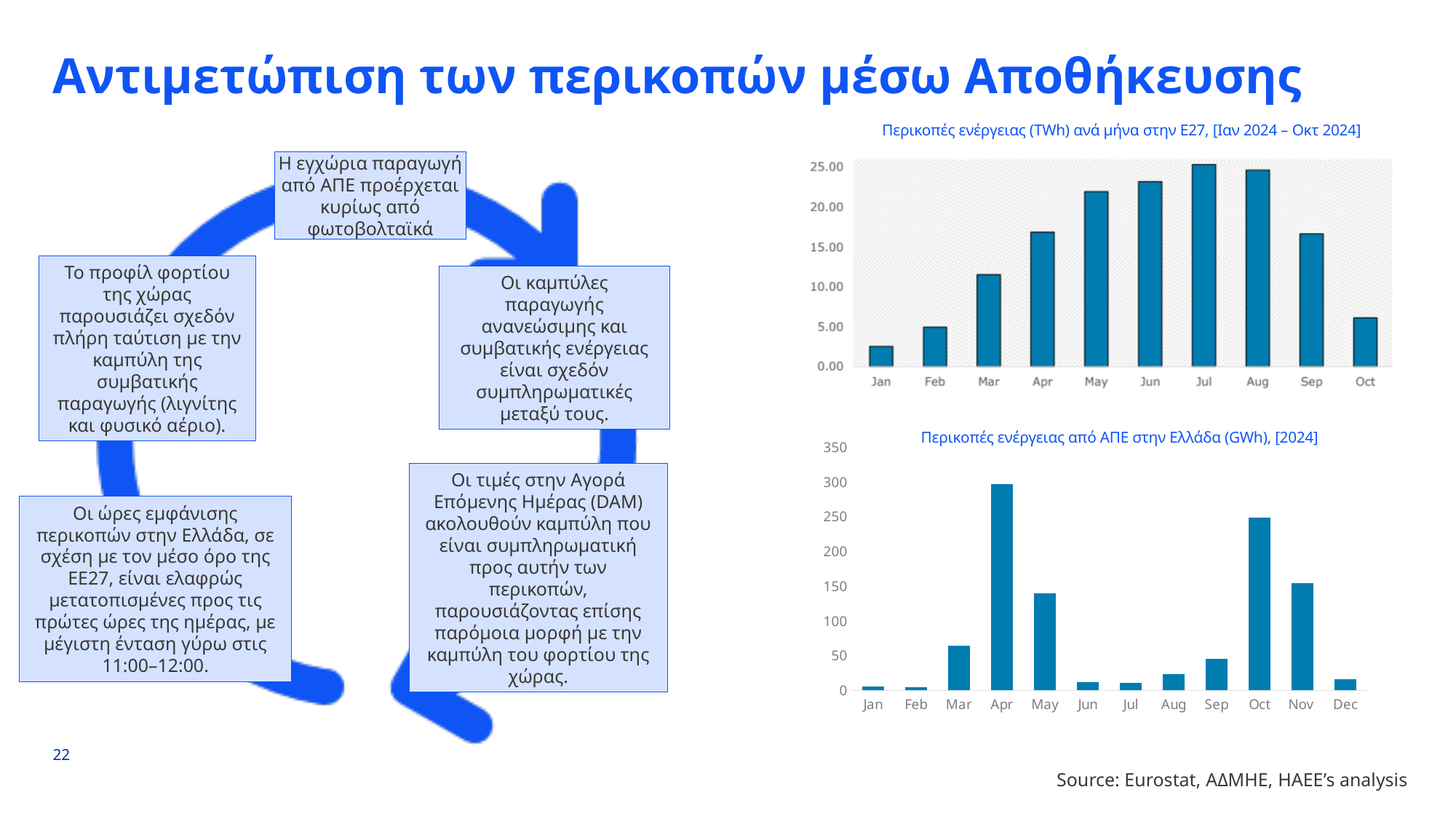
In the top chart (EU27 curtailments in TWh), which is larger, the value for May or the value for Oct? May In the top chart (EU27 curtailments in TWh), is the value for Apr greater or less than 15.00? greater In the bottom chart (Greece RES curtailments in GWh), is the value for Mar greater or less than 50? greater In the top chart (EU27 curtailments in TWh), which month has the highest value? Jul In the top chart (EU27 curtailments in TWh), which month has the lowest value? Jan In the bottom chart (Greece RES curtailments in GWh), which is larger, the value for Oct or the value for Aug? Oct In the bottom chart (Greece RES curtailments in GWh), is the value for May greater or less than 100? greater How many months are shown on the x axis of the top chart (EU27 curtailments in TWh)? 10 How many months are shown on the x axis of the bottom chart (Greece RES curtailments in GWh)? 12 In the bottom chart (Greece RES curtailments in GWh, 2024), which month has the highest value? Apr What kind of chart is the top chart, 'Περικοπές ενέργειας (TWh) ανά μήνα στην Ε27'? bar chart